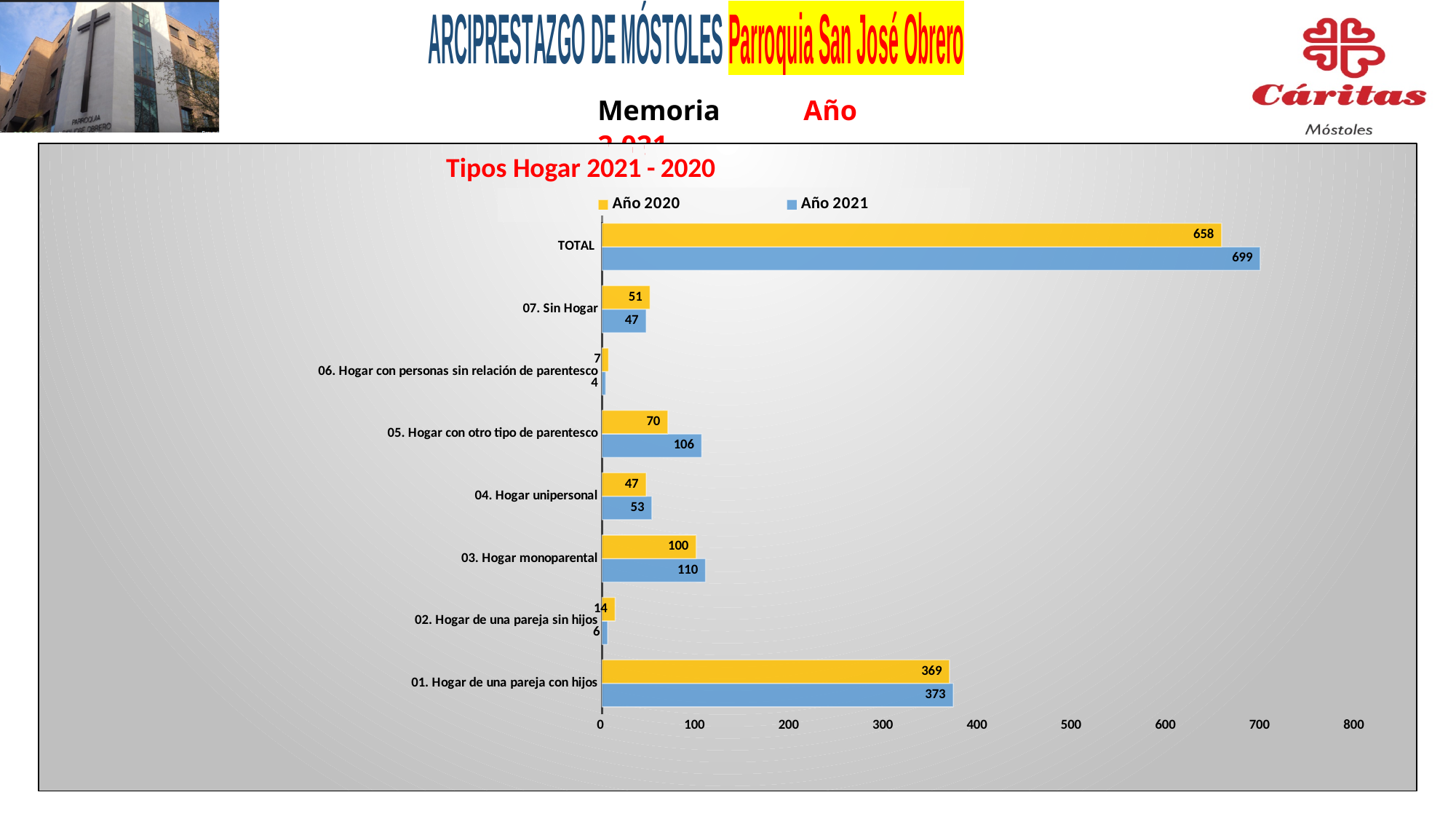
Excluding TOTAL, which category has the highest Año 2021 value? 01. Hogar de una pareja con hijos Excluding TOTAL, which category has the lowest Año 2020 value? 06. Hogar con personas sin relación de parentesco What is the difference between the Año 2021 and Año 2020 values for 05. Hogar con otro tipo de parentesco? 36 What is the value for Año 2020 for 05. Hogar con otro tipo de parentesco? 70 For 07. Sin Hogar, which is larger: the Año 2020 value or the Año 2021 value? Año 2020 How many series does the legend list? 2 What is the difference between the Año 2021 and Año 2020 values for TOTAL? 41 What type of chart is shown on the slide? bar chart What is the value for Año 2021 for 03. Hogar monoparental? 110 What is the value for Año 2021 for TOTAL? 699 How many categories are shown on the y axis of the chart? 8 Is the Año 2020 value for 01. Hogar de una pareja con hijos greater or less than 300? greater